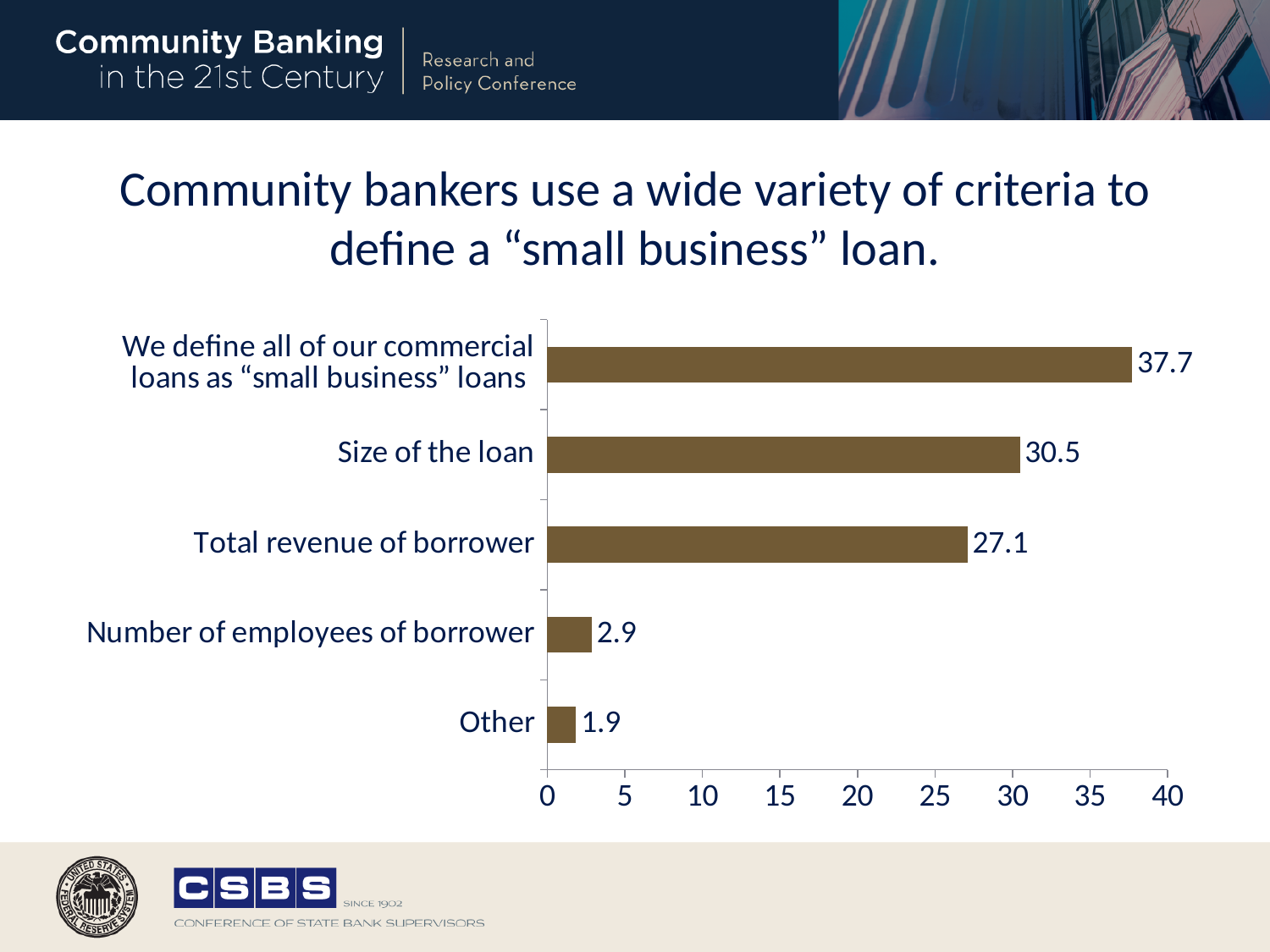
Is the value for "Total revenue of borrower" greater or less than 25? greater What is the value for "Number of employees of borrower"? 2.9 What kind of chart is shown on the slide? bar chart What is the value for "Other"? 1.9 What is the highest value shown on the x axis? 40 What is the value for "Size of the loan"? 30.5 What is the value for "Total revenue of borrower"? 27.1 Which category has the lowest value? Other Which category has the highest value? We define all of our commercial loans as "small business" loans What is the difference between the values for "Size of the loan" and "Total revenue of borrower"? 3.4 Which is larger, the value for "Number of employees of borrower" or the value for "Other"? Number of employees of borrower How many categories are shown in the chart? 5